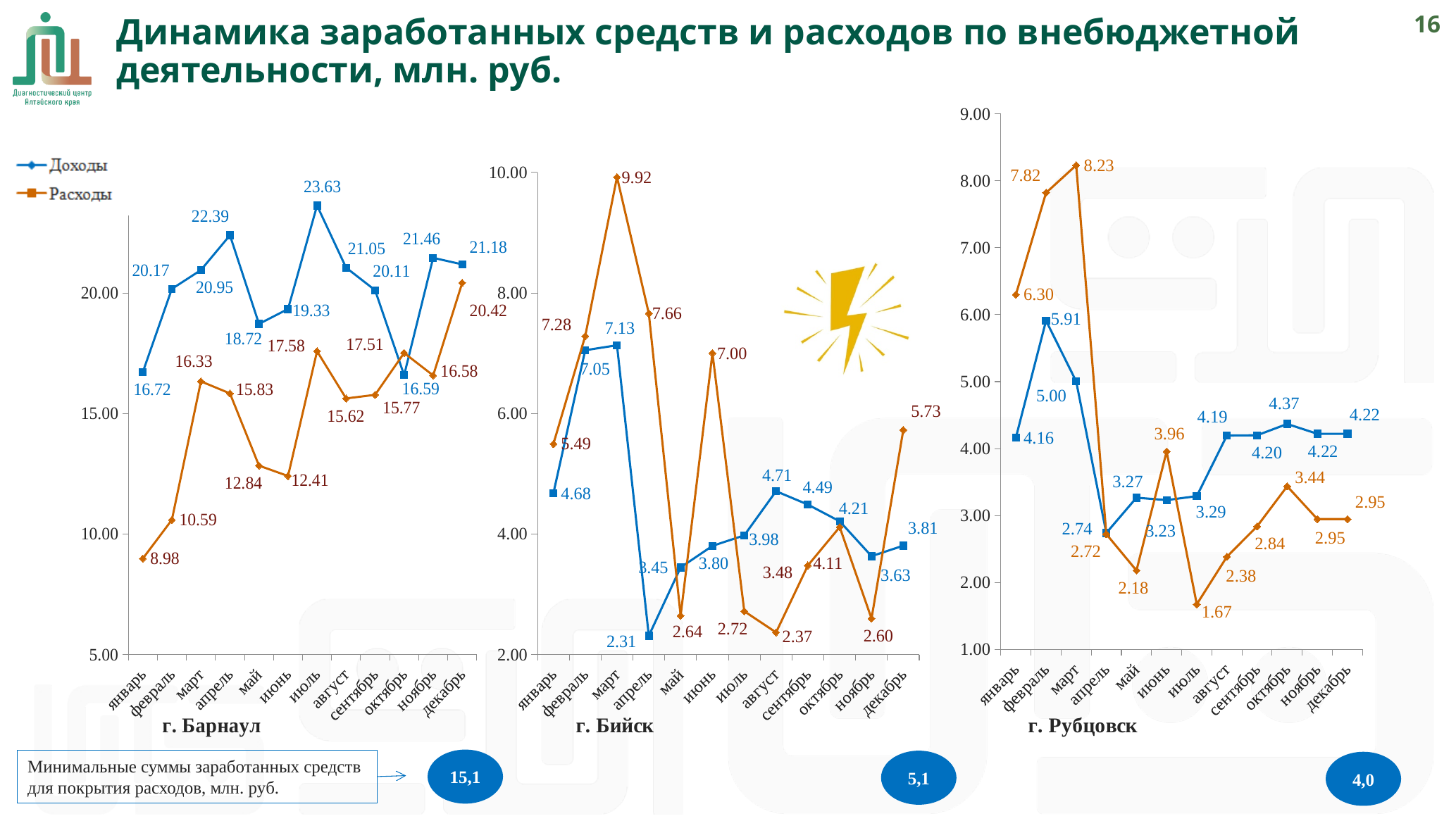
On the г. Бийск chart, what is the value of Расходы for март? 9.92 On the г. Рубцовск chart, in which month is Доходы highest? февраль On the г. Барнаул chart, what is the difference between Доходы and Расходы in январь? 7.74 On the г. Бийск chart, which is larger in июнь, Доходы or Расходы? Расходы On the г. Бийск chart, in which month is Доходы lowest? апрель On the г. Барнаул chart, what is the value of Доходы for июль? 23.63 On the г. Рубцовск chart, what is the value of Расходы for июль? 1.67 On the г. Барнаул chart, in which month is Расходы lowest? январь On the г. Рубцовск chart, what is the difference between Расходы and Доходы in март? 3.23 How many series does the legend list? 2 What type of chart is used for г. Барнаул? line chart How many months are plotted on the г. Бийск chart? 12